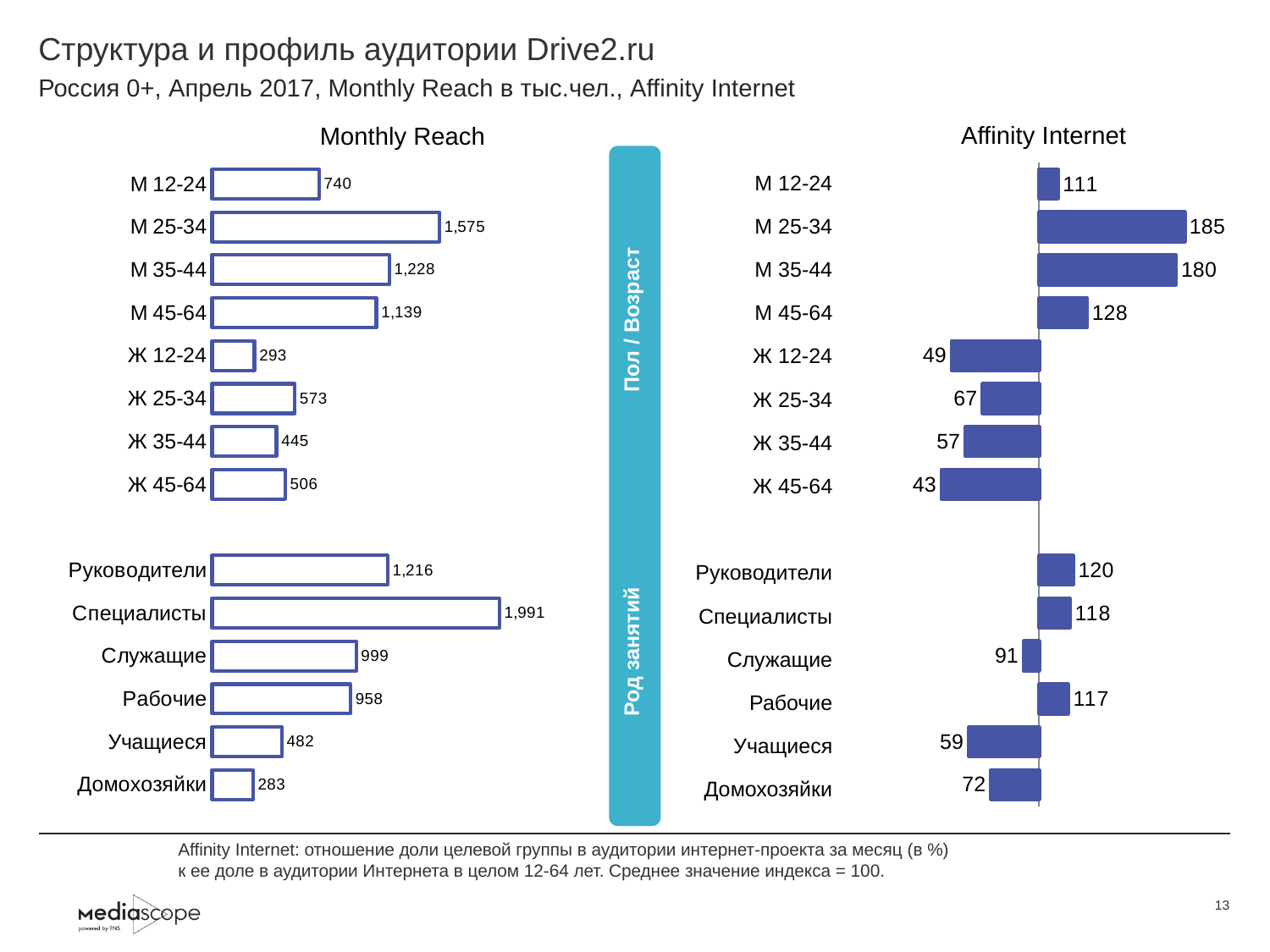
In the Monthly Reach chart, what is the value for М 25-34? 1,575 What kind of chart is the Affinity Internet chart? Bar chart In the Monthly Reach chart, which is larger: the value for Ж 25-34 or the value for Ж 45-64? Ж 25-34 In the Monthly Reach chart, which category has the highest value? Специалисты In the Monthly Reach chart, what is the value for Домохозяйки? 283 In the Affinity Internet chart, which is larger: the value for Руководители or the value for Рабочие? Руководители In the Affinity Internet chart, what is the difference between the values for М 25-34 and М 35-44? 5 In the Monthly Reach chart, what is the difference between the values for М 35-44 and М 45-64? 89 How many categories are plotted in the Monthly Reach chart? 14 In the Affinity Internet chart, which category has the lowest value? Ж 45-64 In the Affinity Internet chart, what is the value for Ж 45-64? 43 In the Affinity Internet chart, which category has the highest value? М 25-34